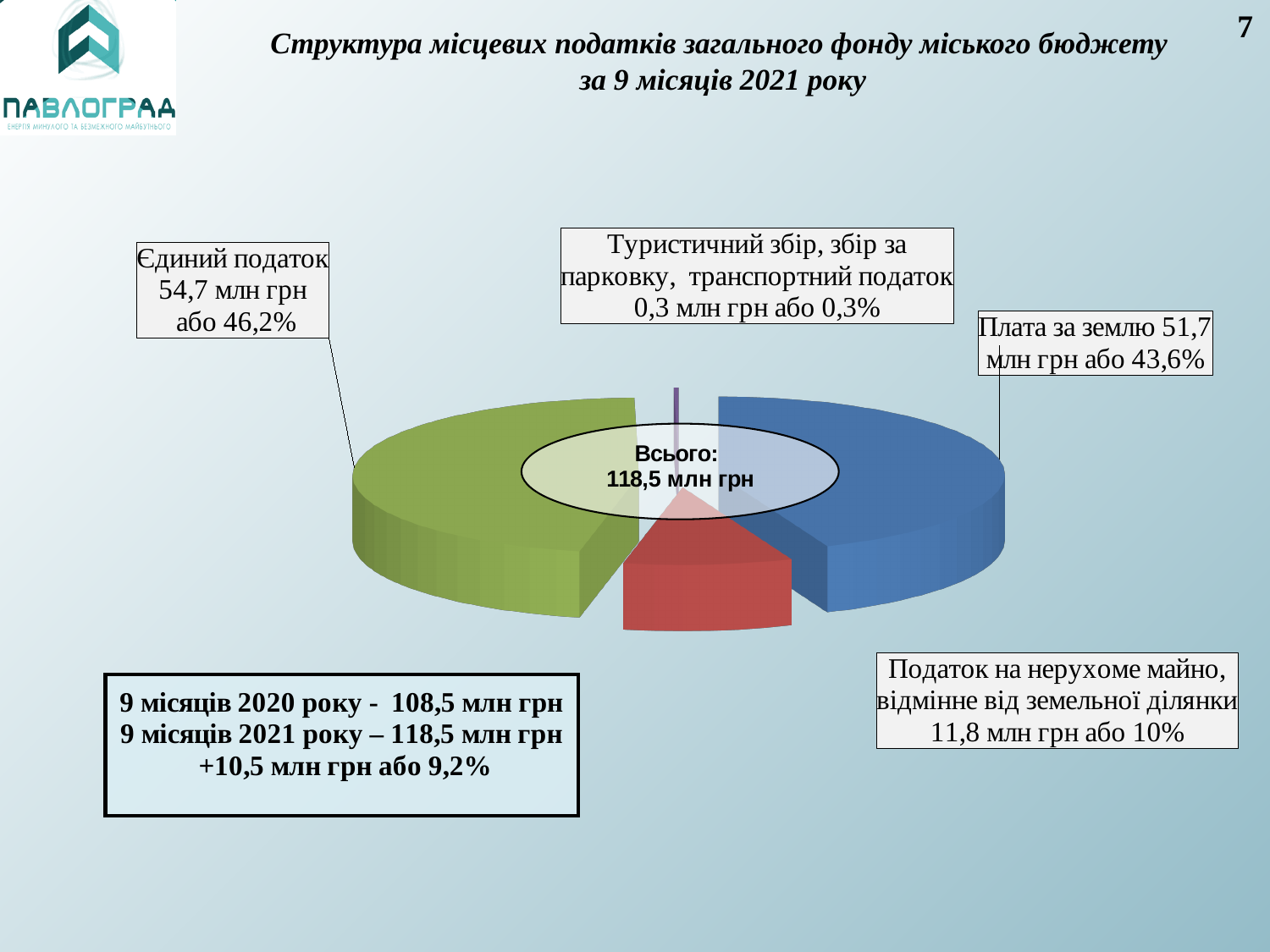
Which is larger, Плата за землю or Податок на нерухоме майно? Плата за землю What share of the pie does Плата за землю represent? 43,6% What is the value for Податок на нерухоме майно, відмінне від земельної ділянки? 11,8 млн грн What share of the pie does Туристичний збір, збір за парковку, транспортний податок represent? 0,3% How many slices does the pie chart have? 4 What total is shown in the centre of the pie chart? 118,5 млн грн Which category has the largest slice of the pie? Єдиний податок Which category has the smallest slice of the pie? Туристичний збір, збір за парковку, транспортний податок What type of chart is shown on the slide? Pie chart What is the difference between Єдиний податок and Плата за землю in млн грн? 3,0 млн грн What is the value for Плата за землю? 51,7 млн грн What is the value for Єдиний податок? 54,7 млн грн